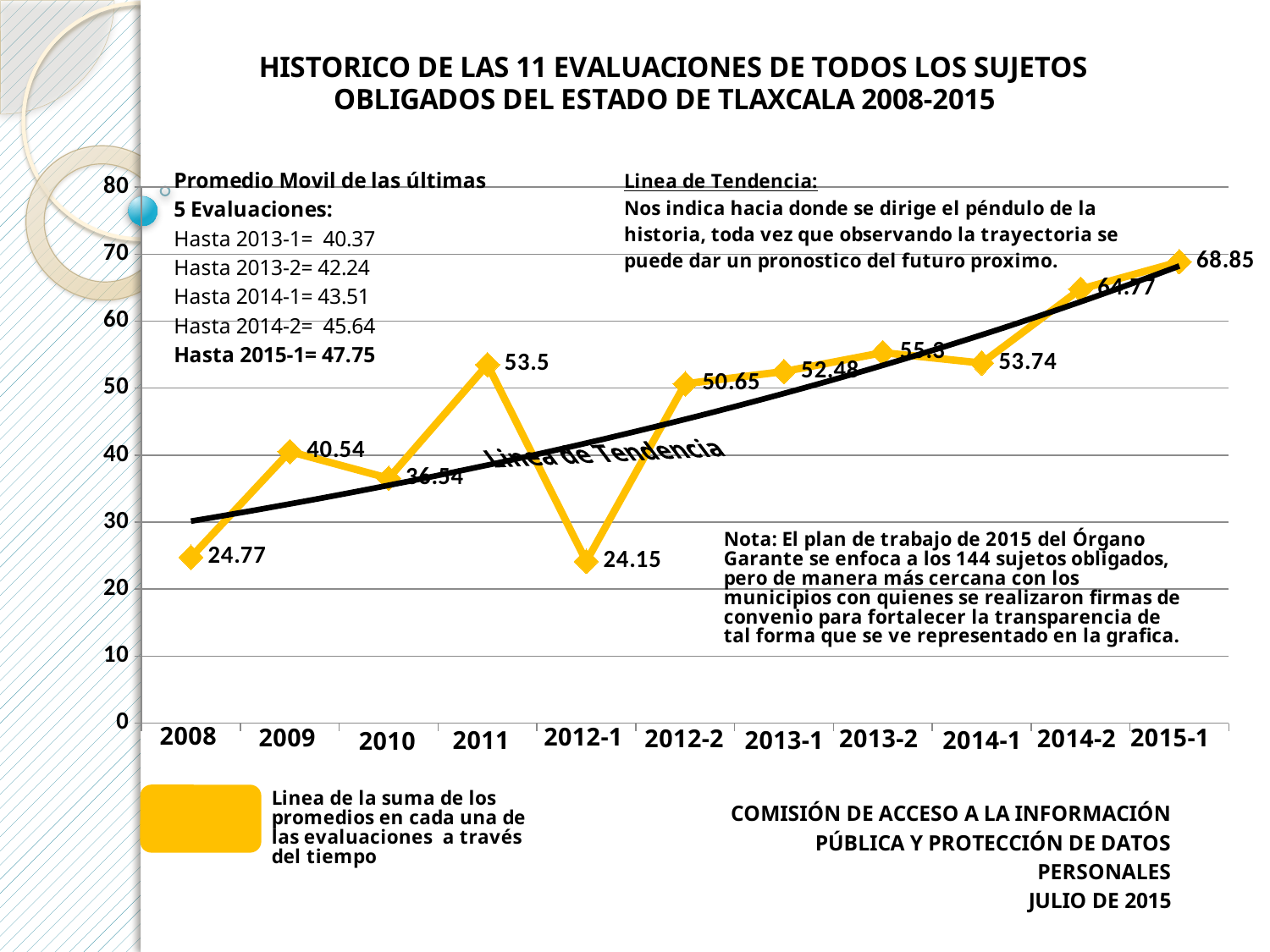
What is the value plotted for 2014-1? 53.74 What is the value plotted for 2012-1? 24.15 Which evaluation period has the highest value on the chart? 2015-1 Which is larger, the value for 2012-2 or the value for 2013-1? 2013-1 Is the value for 2010 greater or less than 40? less What is the difference between the values for 2015-1 and 2008? 44.08 What kind of chart is shown on the slide? line chart What is the value plotted for 2011? 53.5 What is the value plotted for 2008? 24.77 Does the black 'Linea de Tendencia' rise or fall from 2008 to 2015-1? rise What is the value plotted for 2015-1? 68.85 How many evaluation periods are plotted on the x axis? 11